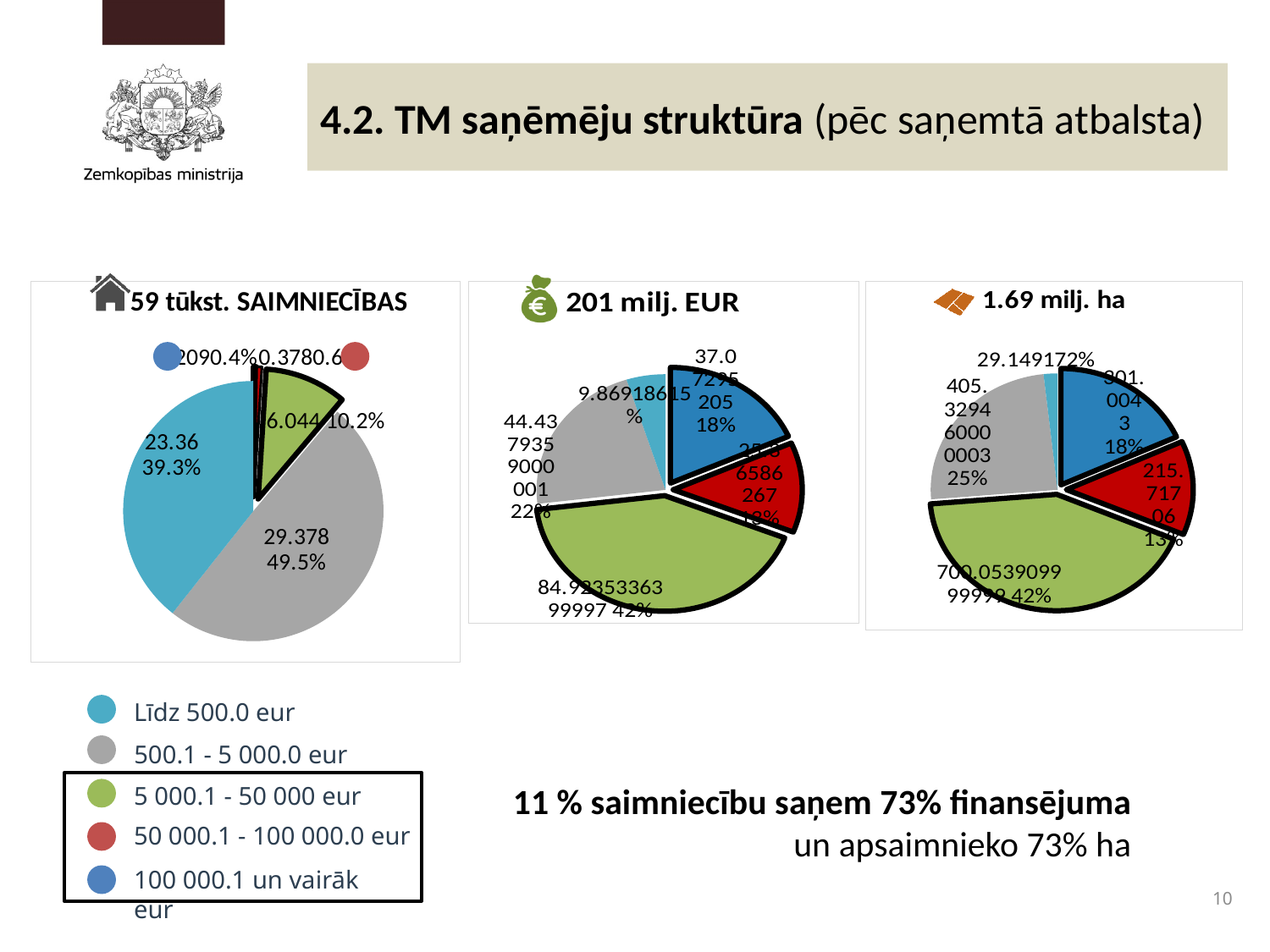
In the "59 tūkst. SAIMNIECĪBAS" chart, what percentage share is shown for the grey slice (500.1 - 5 000.0 eur)? 49.5% In the "1.69 milj. ha" chart, which slice is larger: the green (5 000.1 - 50 000 eur) or the blue (100 000.1 un vairāk eur)? green (5 000.1 - 50 000 eur) In the "201 milj. EUR" chart, what percentage share is shown for the blue slice (100 000.1 un vairāk eur)? 18% In the "59 tūkst. SAIMNIECĪBAS" chart, what percentage share is shown for the teal slice (Līdz 500.0 eur)? 39.3% In the "59 tūkst. SAIMNIECĪBAS" chart, which category has the largest slice? 500.1 - 5 000.0 eur In the "59 tūkst. SAIMNIECĪBAS" chart, what percentage share is shown for the green slice (5 000.1 - 50 000 eur)? 10.2% What kind of chart is used on this slide for the "59 tūkst. SAIMNIECĪBAS" chart? pie chart In the "1.69 milj. ha" chart, what percentage share is shown for the grey slice (500.1 - 5 000.0 eur)? 25% In the "201 milj. EUR" chart, which category has the largest slice? 5 000.1 - 50 000 eur How many categories does the legend at the bottom left of the slide list? 5 In the "201 milj. EUR" chart, what percentage share is shown for the green slice (5 000.1 - 50 000 eur)? 42% In the "1.69 milj. ha" chart, what percentage share is shown for the red slice (50 000.1 - 100 000.0 eur)? 13%